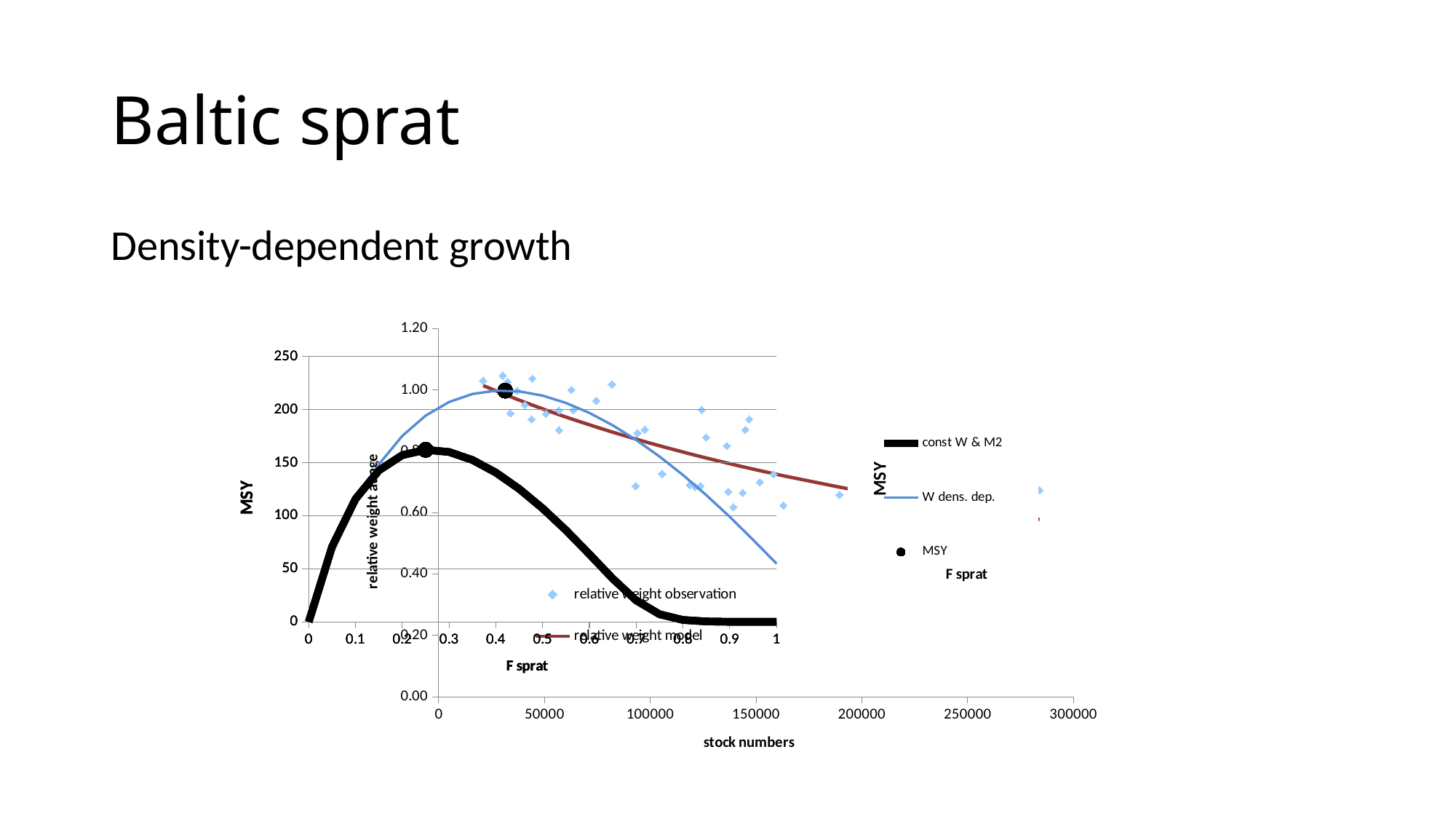
In the relative weight vs stock numbers chart, what is the label of the horizontal axis? stock numbers In the relative weight vs stock numbers chart, does the relative weight model line rise or fall as stock numbers increase? fall In the MSY vs F sprat chart, is the peak value of the const W & M2 curve greater or less than 100? greater In the MSY vs F sprat chart, which curve reaches its maximum at a higher value of F sprat: W dens. dep. or const W & M2? W dens. dep. In the MSY vs F sprat chart, is the peak value of the W dens. dep. curve greater or less than 200? greater In the MSY vs F sprat chart, what is the label of the horizontal axis? F sprat In the relative weight vs stock numbers chart, how many series does the legend list? 2 In the MSY vs F sprat chart, is the const W & M2 value at F sprat = 1 greater or less than 50? less In the MSY vs F sprat chart, does the const W & M2 curve rise or fall as F sprat increases from 0.3 to 1? fall In the MSY vs F sprat chart, how many series does the legend list? 3 In the MSY vs F sprat chart, at F sprat = 0.5, which curve is higher: W dens. dep. or const W & M2? W dens. dep. In the MSY vs F sprat chart, what are the three legend entries? const W & M2, W dens. dep., MSY